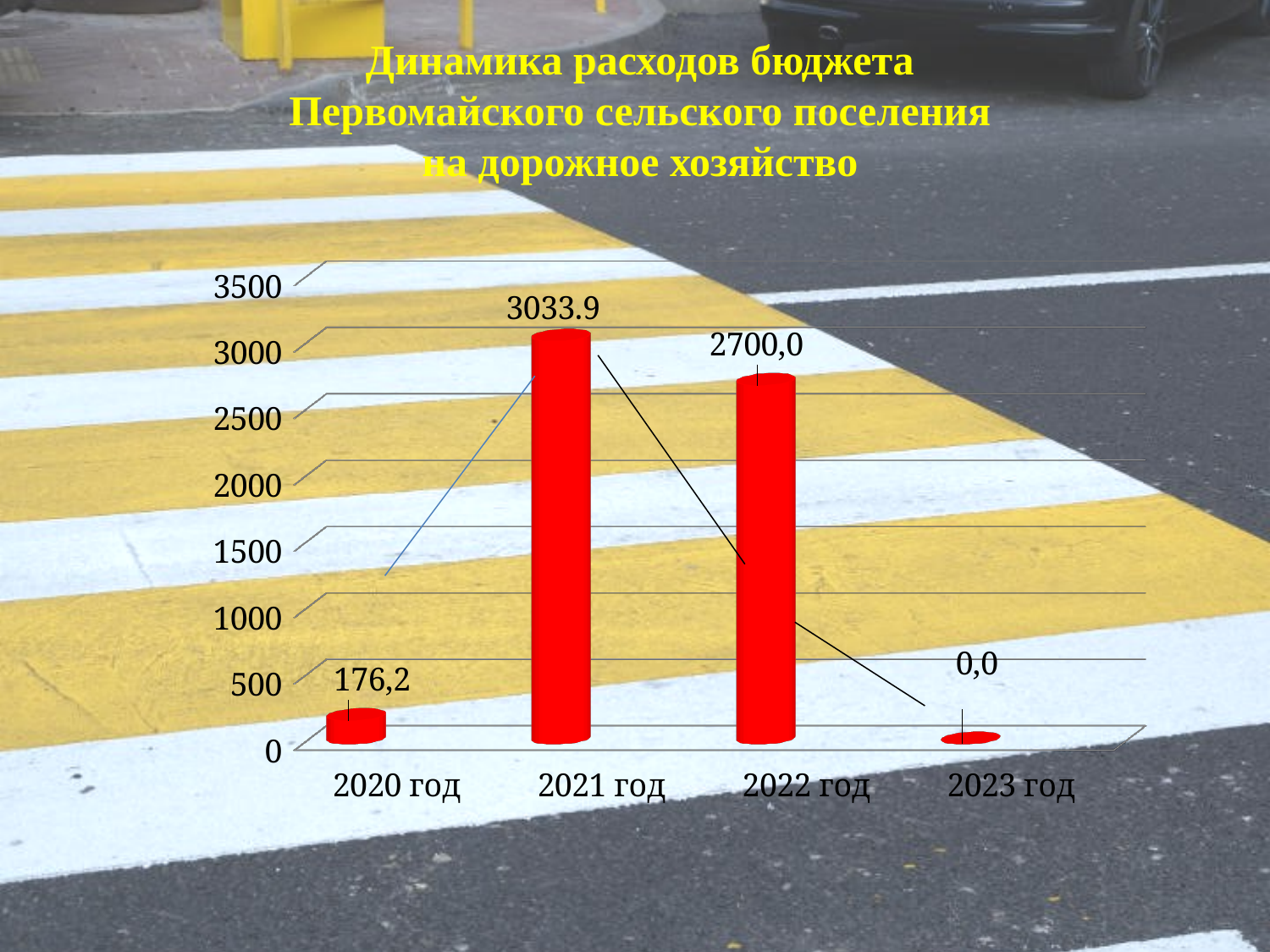
Which year has the highest value? 2021 год What is the difference between the values for 2022 год and 2020 год? 2523,8 Which is larger, the value for 2021 год or 2022 год? 2021 год What is the value for 2021 год? 3033.9 What is the value for 2020 год? 176,2 What is the value for 2023 год? 0,0 How many years are shown on the chart? 4 Which year has the lowest value? 2023 год What kind of chart is shown on the slide? bar chart Is the value for 2021 год greater or less than 3000? greater What is the title of the chart? Динамика расходов бюджета Первомайского сельского поселения на дорожное хозяйство What is the value for 2022 год? 2700,0